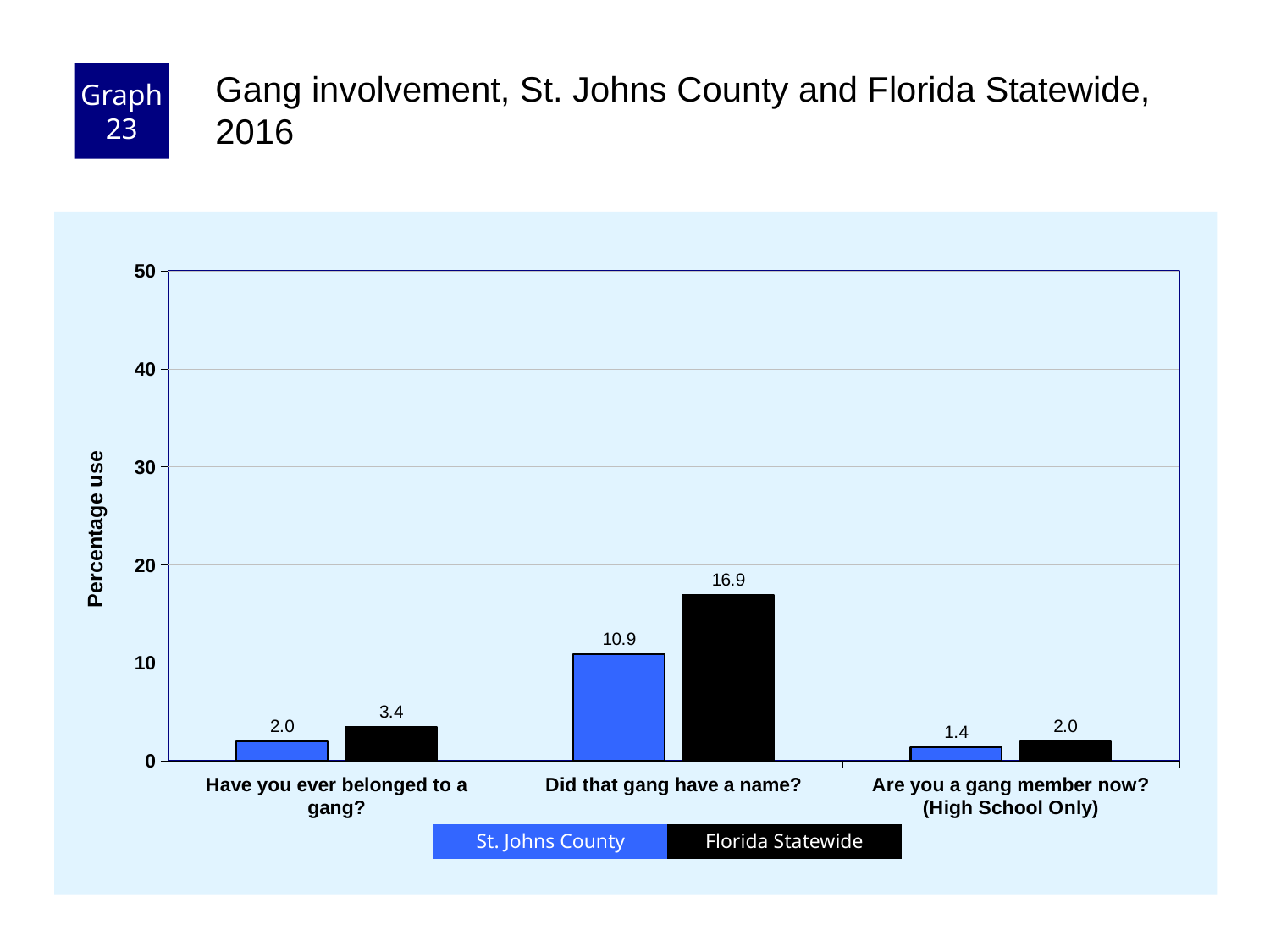
What is the label of the y axis? Percentage use What kind of chart is shown on the slide? bar chart What is the St. Johns County value for "Did that gang have a name?"? 10.9 For "Have you ever belonged to a gang?", which is larger: St. Johns County or Florida Statewide? Florida Statewide Is the Florida Statewide value for "Did that gang have a name?" greater or less than 20? less How many questions (categories) are shown on the x axis? 3 How many series does the legend list? 2 Which question has the lowest St. Johns County value? Are you a gang member now? (High School Only) Which question has the highest Florida Statewide value? Did that gang have a name? What is the Florida Statewide value for "Have you ever belonged to a gang?"? 3.4 What is the St. Johns County value for "Are you a gang member now? (High School Only)"? 1.4 What is the difference between the Florida Statewide and St. Johns County values for "Did that gang have a name?"? 6.0